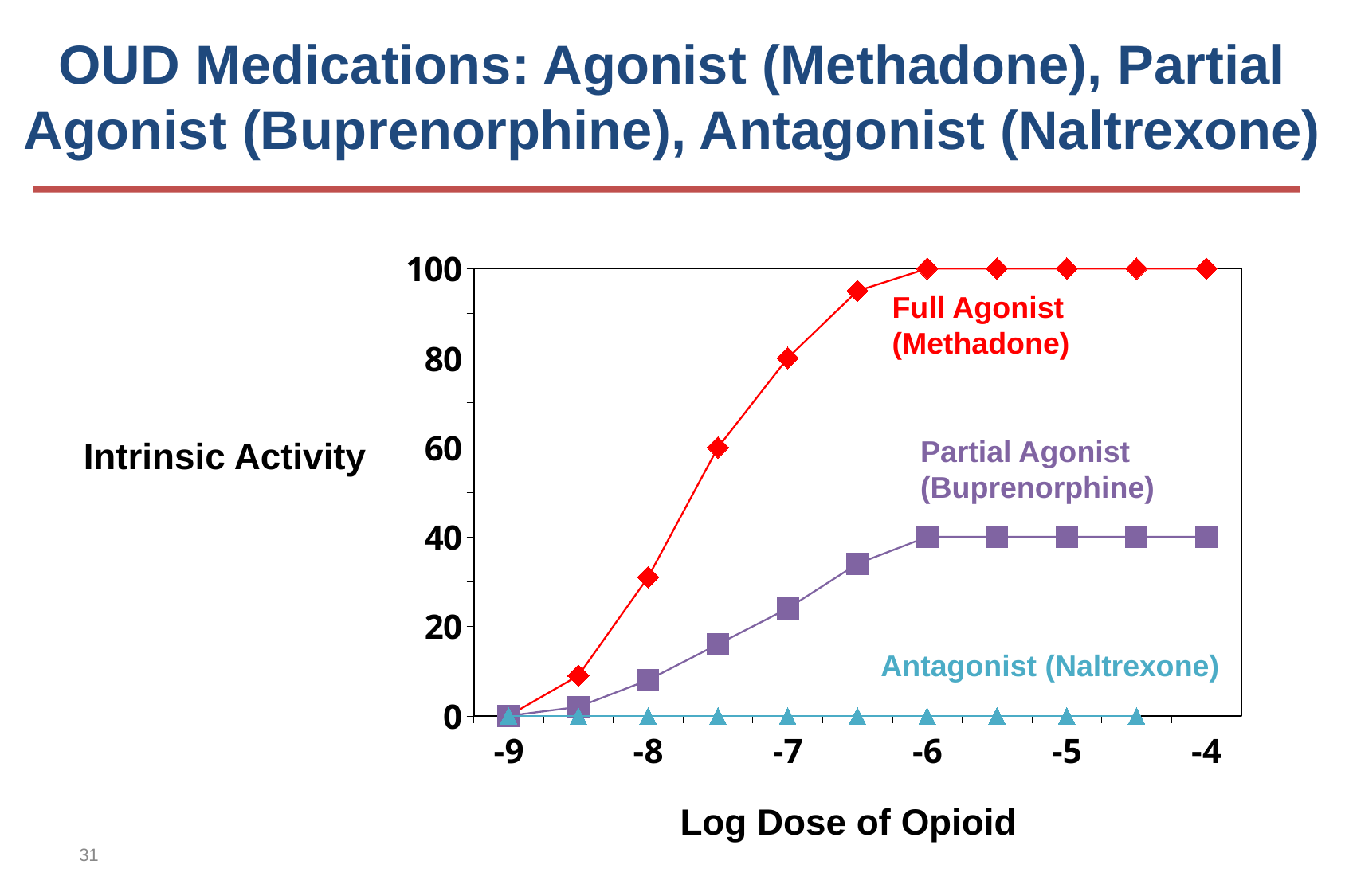
What is the intrinsic activity of the Partial Agonist (Buprenorphine) at a log dose of -5? 40 What is the intrinsic activity of the Full Agonist (Methadone) at a log dose of -7? 80 At a log dose of -8, is the intrinsic activity of the Full Agonist (Methadone) greater or less than 20? greater At a log dose of -7, which has the larger intrinsic activity: the Full Agonist (Methadone) or the Partial Agonist (Buprenorphine)? Full Agonist (Methadone) What kind of chart is shown on the slide? line chart How many series are plotted on the chart? 3 Which series reaches the highest intrinsic activity on the chart? Full Agonist (Methadone) What is the difference in intrinsic activity between the Full Agonist (Methadone) and the Partial Agonist (Buprenorphine) at a log dose of -4? 60 What is the intrinsic activity of the Full Agonist (Methadone) at a log dose of -4? 100 What is the intrinsic activity of the Antagonist (Naltrexone) at a log dose of -6? 0 What is the label of the x axis? Log Dose of Opioid Which series has the lowest intrinsic activity across all doses? Antagonist (Naltrexone)